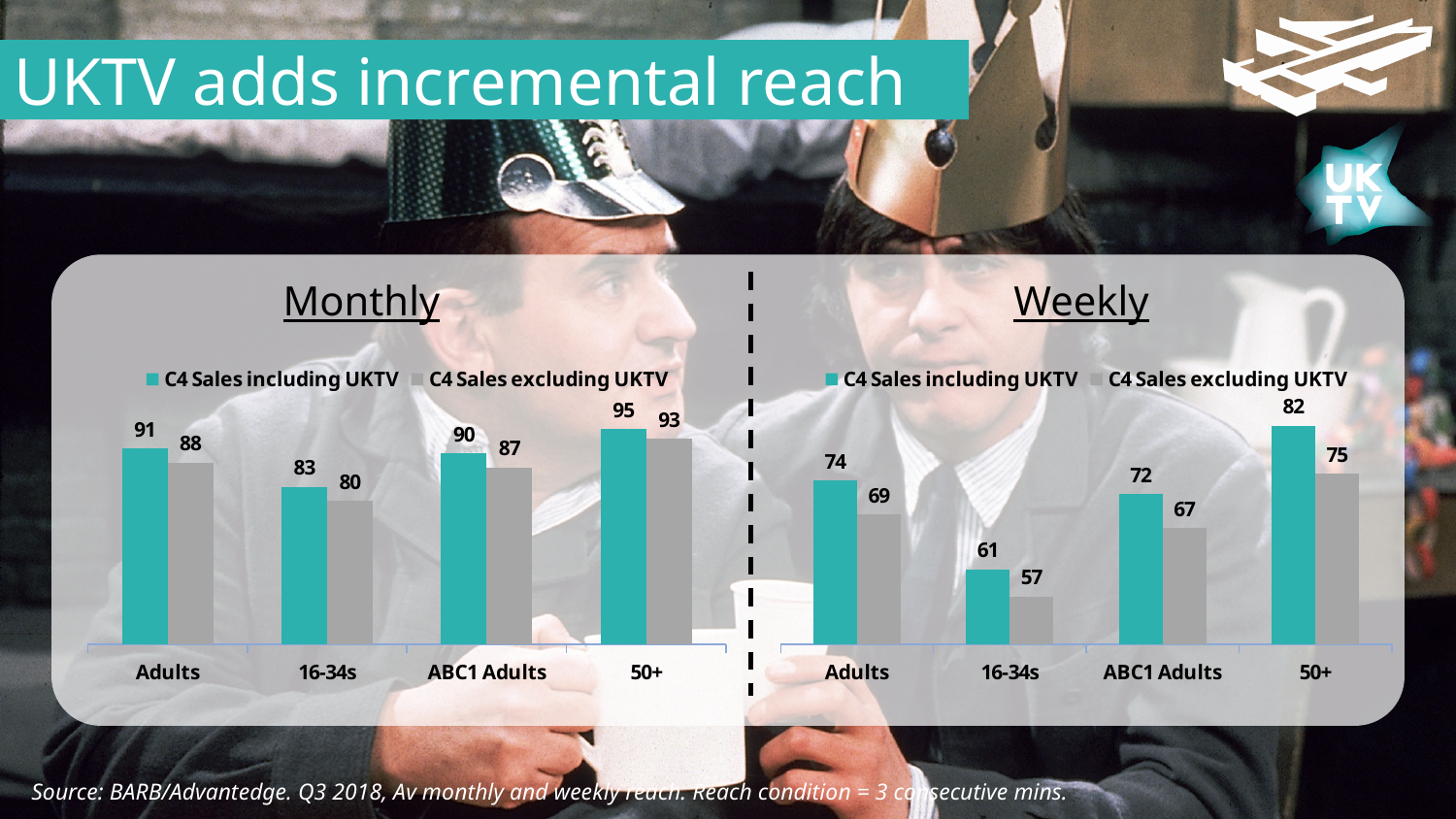
In the Monthly chart, what is the value for C4 Sales excluding UKTV for ABC1 Adults? 87 What kind of chart is the Weekly chart? Bar chart How many categories are shown on the x axis of the Monthly chart? 4 In the Weekly chart, what is the difference between C4 Sales including UKTV and C4 Sales excluding UKTV for Adults? 5 What colour are the C4 Sales including UKTV bars in the Monthly chart? Teal In the Weekly chart, which category has the lowest value for C4 Sales excluding UKTV? 16-34s How many series does the legend of the Weekly chart list? 2 In the Monthly chart, what is the value for C4 Sales including UKTV for Adults? 91 In the Weekly chart, what is the value for C4 Sales excluding UKTV for 16-34s? 57 In the Monthly chart, what is the difference between C4 Sales including UKTV and C4 Sales excluding UKTV for 16-34s? 3 In the Monthly chart, which category has the highest value for C4 Sales including UKTV? 50+ In the Weekly chart, which is larger for ABC1 Adults: C4 Sales including UKTV or C4 Sales excluding UKTV? C4 Sales including UKTV